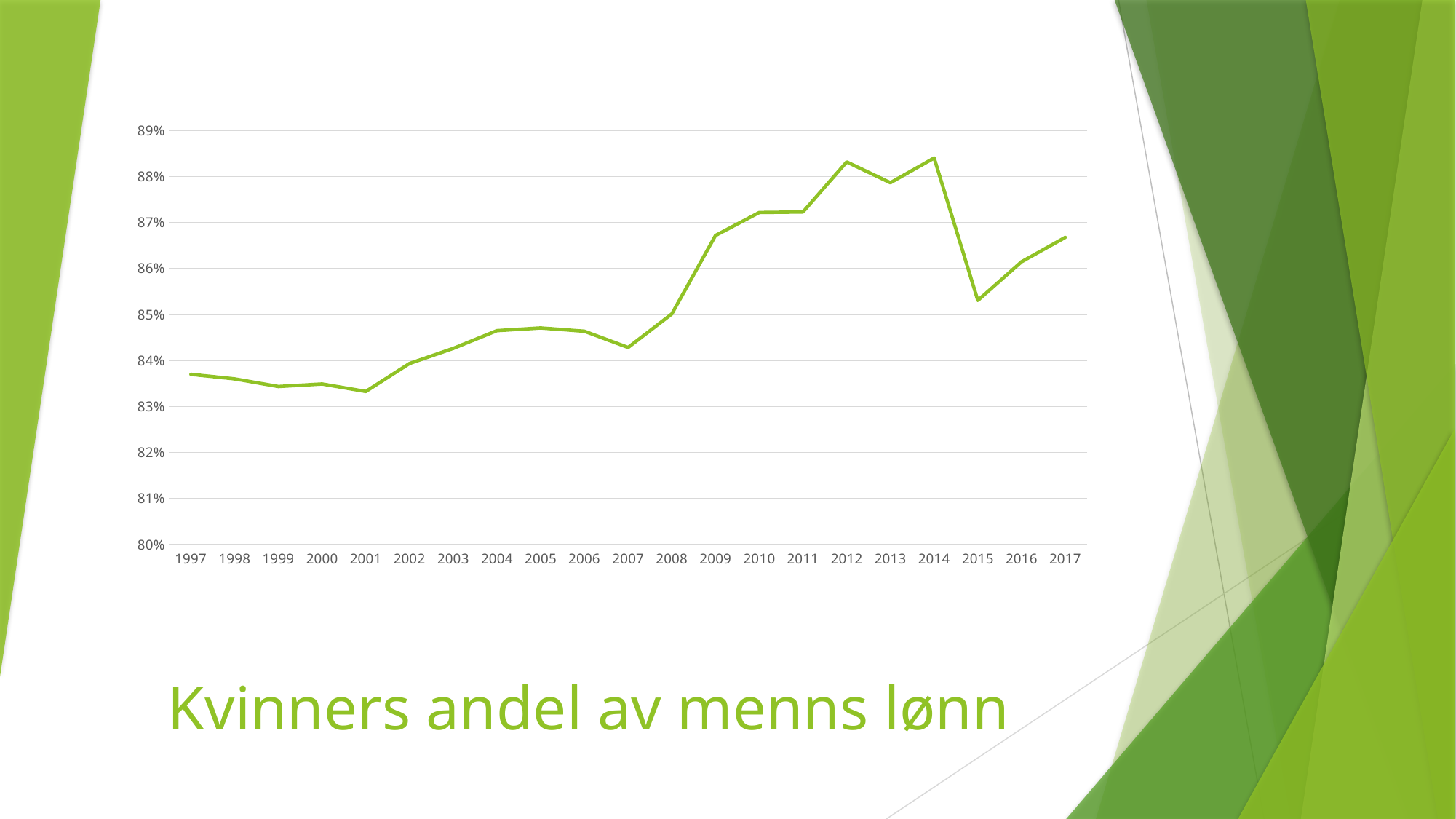
Is the value for 2012 greater or less than 88%? greater Does the value rise or fall from 2001 to 2005? rise How many years are plotted along the x axis of the chart? 21 Is the value for 2015 greater or less than 86%? less Which year has the larger value, 1997 or 2017? 2017 What kind of chart is shown on the slide? line chart Is the value for 2001 greater or less than 84%? less What is the title shown on the slide for the chart? Kvinners andel av menns lønn Which year has the lowest value on the chart? 2001 Does the value rise or fall from 2014 to 2015? fall Which year has the larger value, 2012 or 2015? 2012